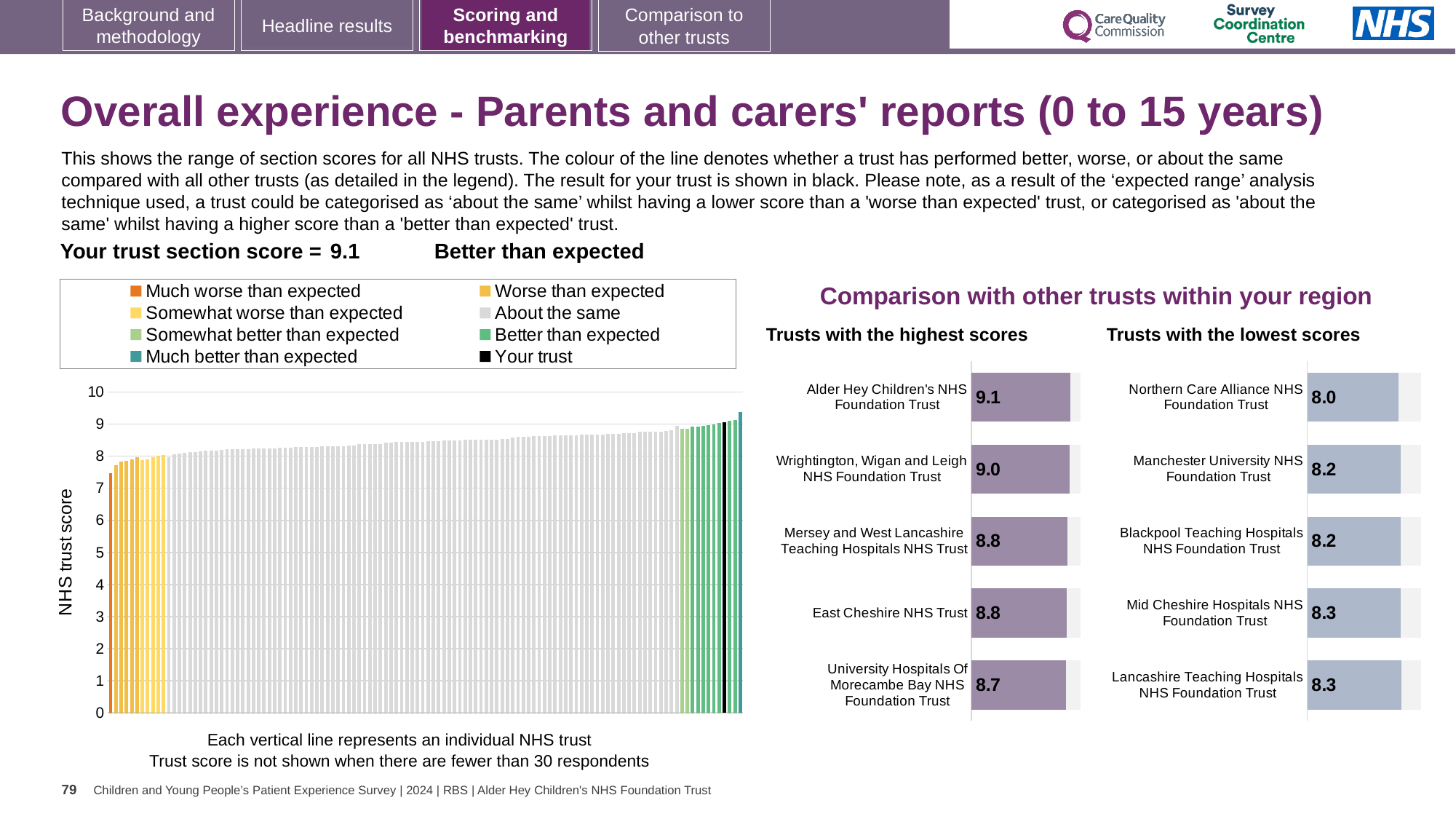
In the 'Trusts with the highest scores' chart, which trust has the highest score? Alder Hey Children's NHS Foundation Trust In the NHS trust score chart on the left, do the values rise or fall from left to right? Rise In the 'Trusts with the lowest scores' chart, what is the difference between the scores of Lancashire Teaching Hospitals NHS Foundation Trust and Northern Care Alliance NHS Foundation Trust? 0.3 In the 'Trusts with the lowest scores' chart, what is the score for Northern Care Alliance NHS Foundation Trust? 8.0 In the 'Trusts with the lowest scores' chart, which trust has the lowest score? Northern Care Alliance NHS Foundation Trust How many trusts are shown in the 'Trusts with the highest scores' chart? 5 In the 'Trusts with the highest scores' chart, what is the score for Alder Hey Children's NHS Foundation Trust? 9.1 In the 'Trusts with the highest scores' chart, what is the difference between the scores of Alder Hey Children's NHS Foundation Trust and University Hospitals Of Morecambe Bay NHS Foundation Trust? 0.4 In the 'Trusts with the lowest scores' chart, what is the score for Mid Cheshire Hospitals NHS Foundation Trust? 8.3 How many entries does the legend of the NHS trust score chart on the left list? 8 What kind of chart is the NHS trust score chart on the left of the slide? Bar chart In the 'Trusts with the highest scores' chart, which has the higher score: Wrightington, Wigan and Leigh NHS Foundation Trust or Mersey and West Lancashire Teaching Hospitals NHS Trust? Wrightington, Wigan and Leigh NHS Foundation Trust